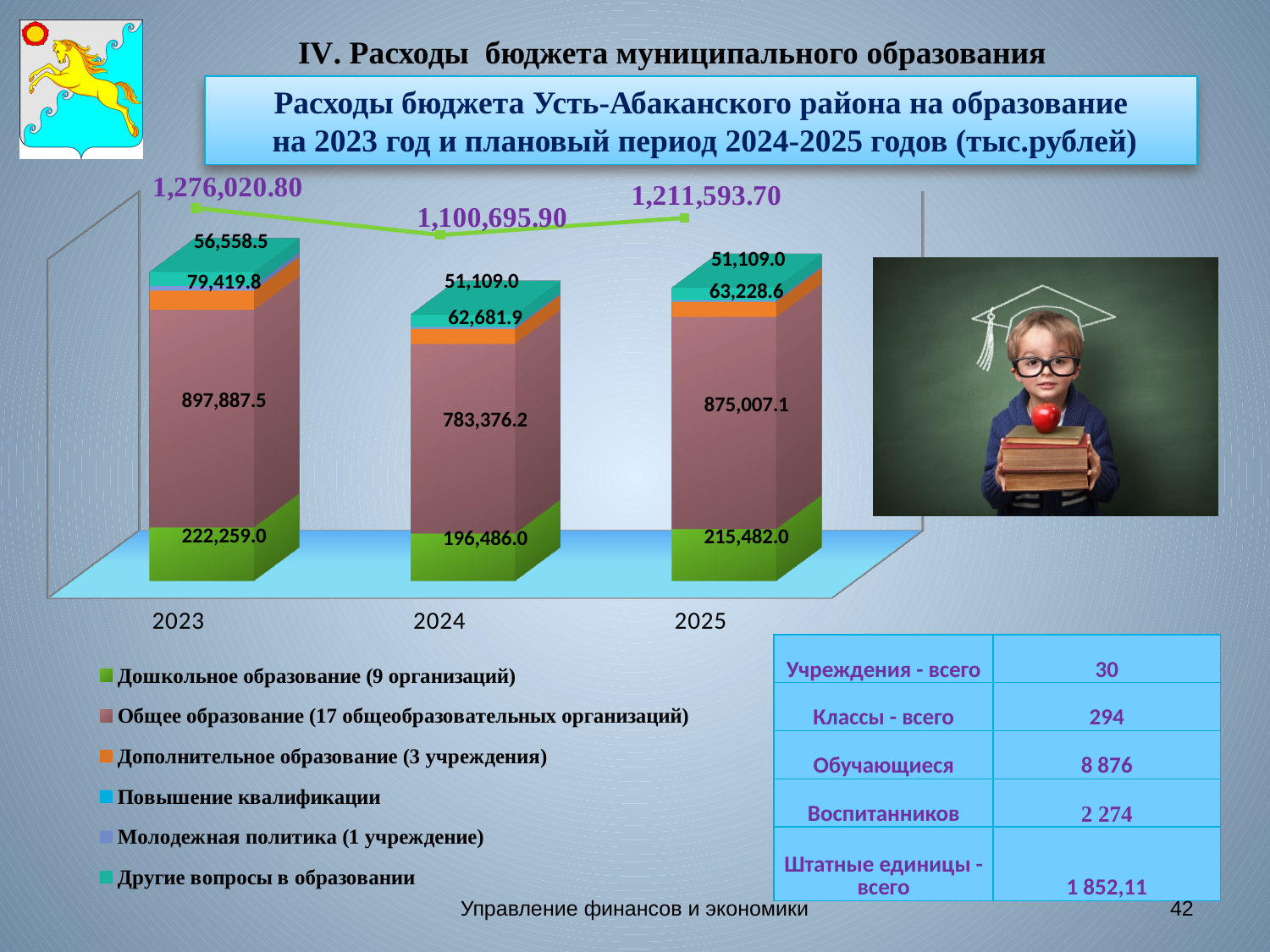
How many years are shown on the x axis of the chart? 3 What is the total education expenditure shown for 2025? 1,211,593.70 How many series does the chart legend list? 6 What is the difference between the Общее образование values for 2023 and 2025? 22,880.4 What is the difference between the Дошкольное образование values for 2023 and 2024? 25,773.0 Which year has the lowest total education expenditure? 2024 Which year has the highest total education expenditure? 2023 Which year has the larger value for Дошкольное образование, 2024 or 2025? 2025 Does the total education expenditure rise or fall from 2023 to 2024? Fall What kind of chart is used to show the education expenditure by year? Stacked bar chart What is the value for Дошкольное образование in 2023? 222,259.0 What is the value for Общее образование in 2024? 783,376.2